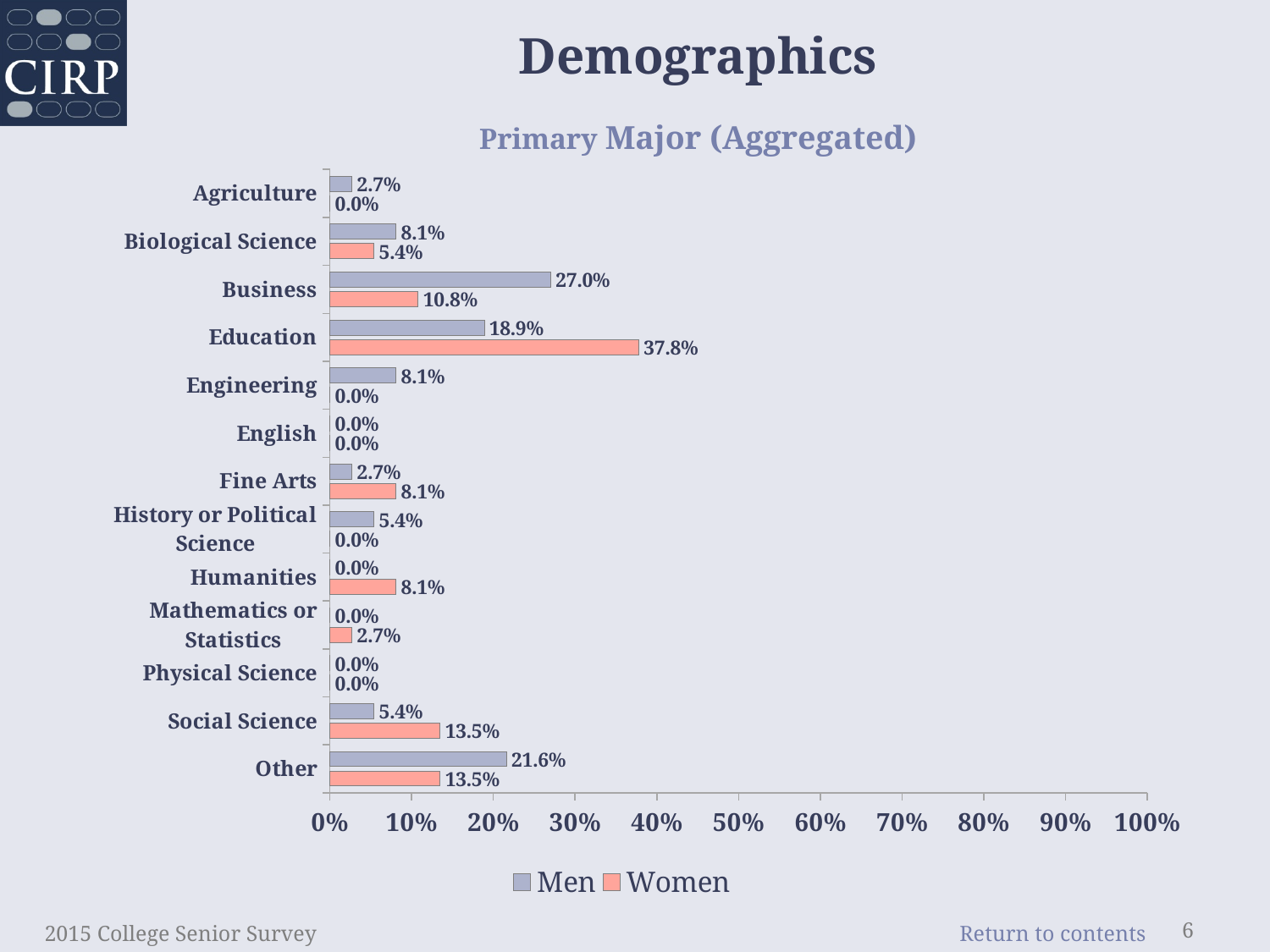
What is the difference between the Women and Men values for Education? 18.9% Which category has the highest value for Women? Education What is the value for Men in the Business category? 27.0% What is the value for Women in the Social Science category? 13.5% How many series does the legend list? 2 How many categories are shown on the chart? 13 Which is larger, the Men value for Other or the Women value for Other? Men What is the value for Women in the Education category? 37.8% Is the value for Women in Education greater or less than 30%? greater What kind of chart is shown on the slide? Bar chart Which category has the highest value for Men? Business What is the difference between the Men and Women values for Business? 16.2%